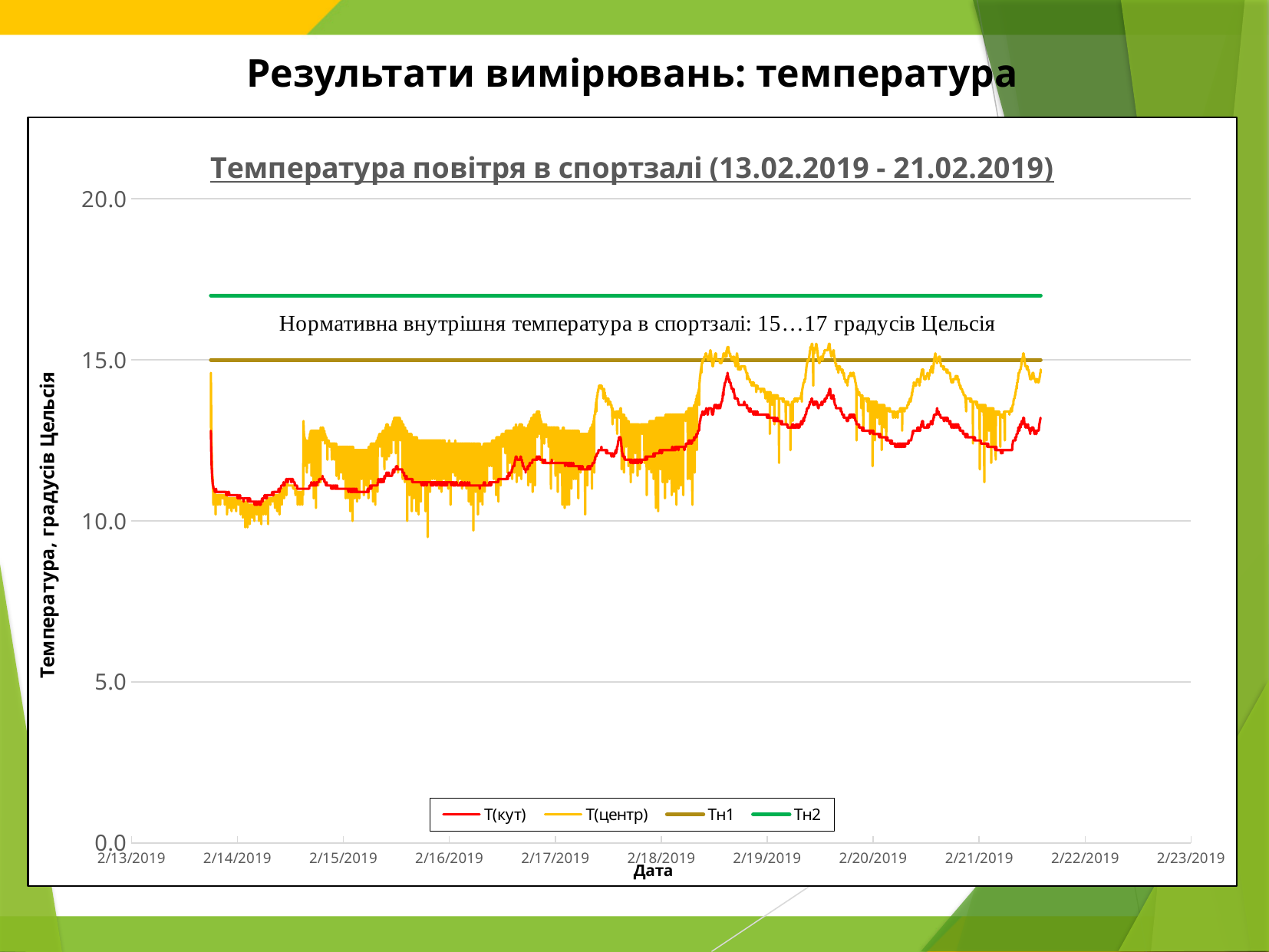
Which of the two constant lines is higher, Тн1 or Тн2? Тн2 How many series does the legend list? 4 Which series is higher on 2/20/2019, T(центр) or T(кут)? T(центр) Does the T(кут) series overall rise or fall from 2/14/2019 to 2/21/2019? rise Is the value for T(кут) on 2/14/2019 greater or less than 15.0? less Is the value for T(центр) on 2/16/2019 greater or less than 15.0? less Is the value for T(кут) on 2/15/2019 greater or less than 10.0? greater What is the label of the vertical axis? Температура, градусів Цельсія What kind of chart is shown on the slide? line chart What constant value does the Тн1 series hold across the chart? 15.0 What is the title of the chart? Температура повітря в спортзалі (13.02.2019 - 21.02.2019)